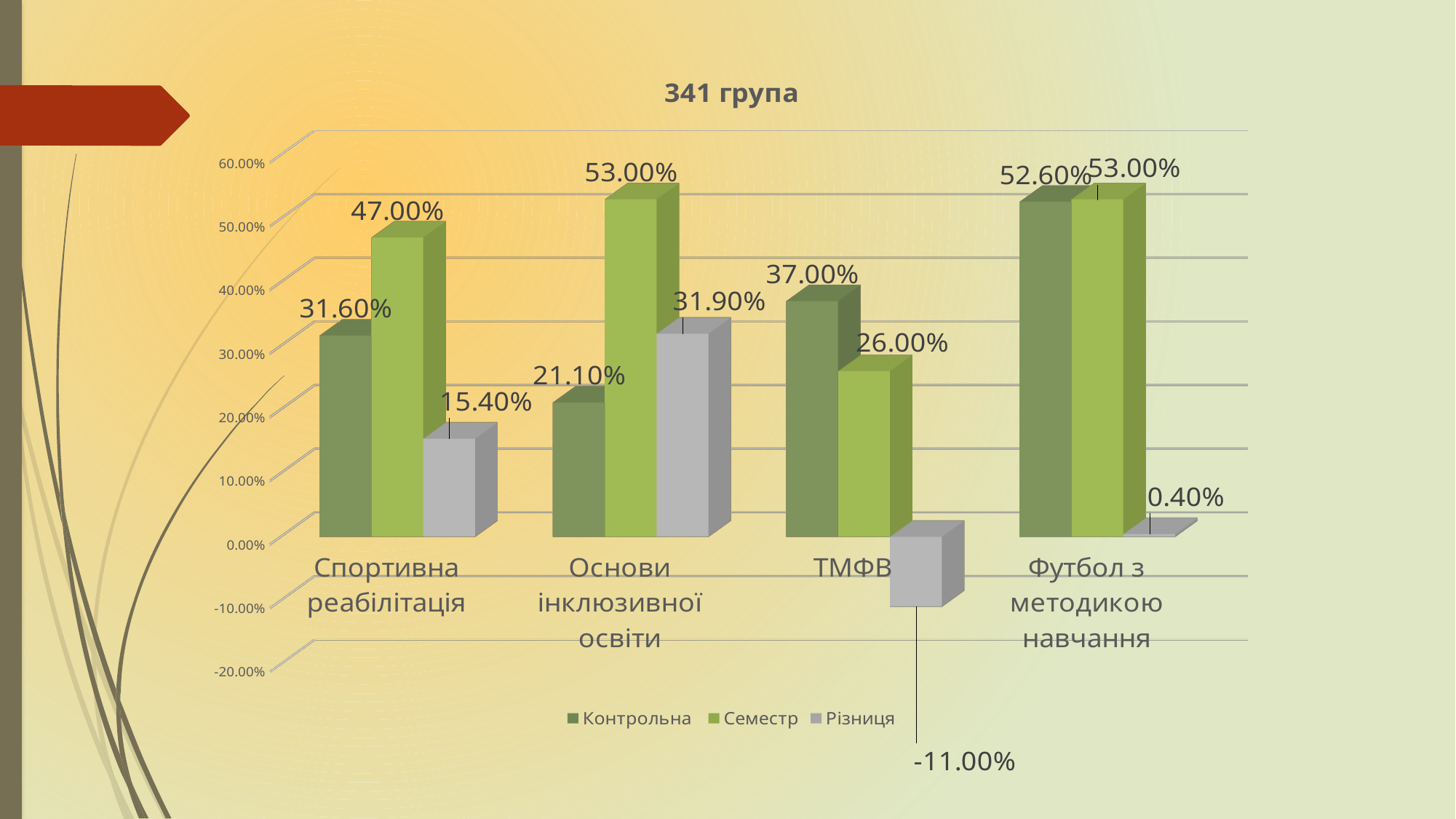
Which category has the lowest Різниця value? ТМФВ Which category has the highest Контрольна value? Футбол з методикою навчання How many categories are shown on the x axis? 4 What is the chart's title? 341 група What is the difference between the Семестр and Контрольна values for Спортивна реабілітація? 15.40% What type of chart is shown on the slide? bar chart Which series is shown in grey? Різниця What is the Контрольна value for Спортивна реабілітація? 31.60% What is the Різниця value for ТМФВ? -11.00% For ТМФВ, which is larger: the Контрольна value or the Семестр value? Контрольна What is the Семестр value for Основи інклюзивної освіти? 53.00% How many series does the legend list? 3